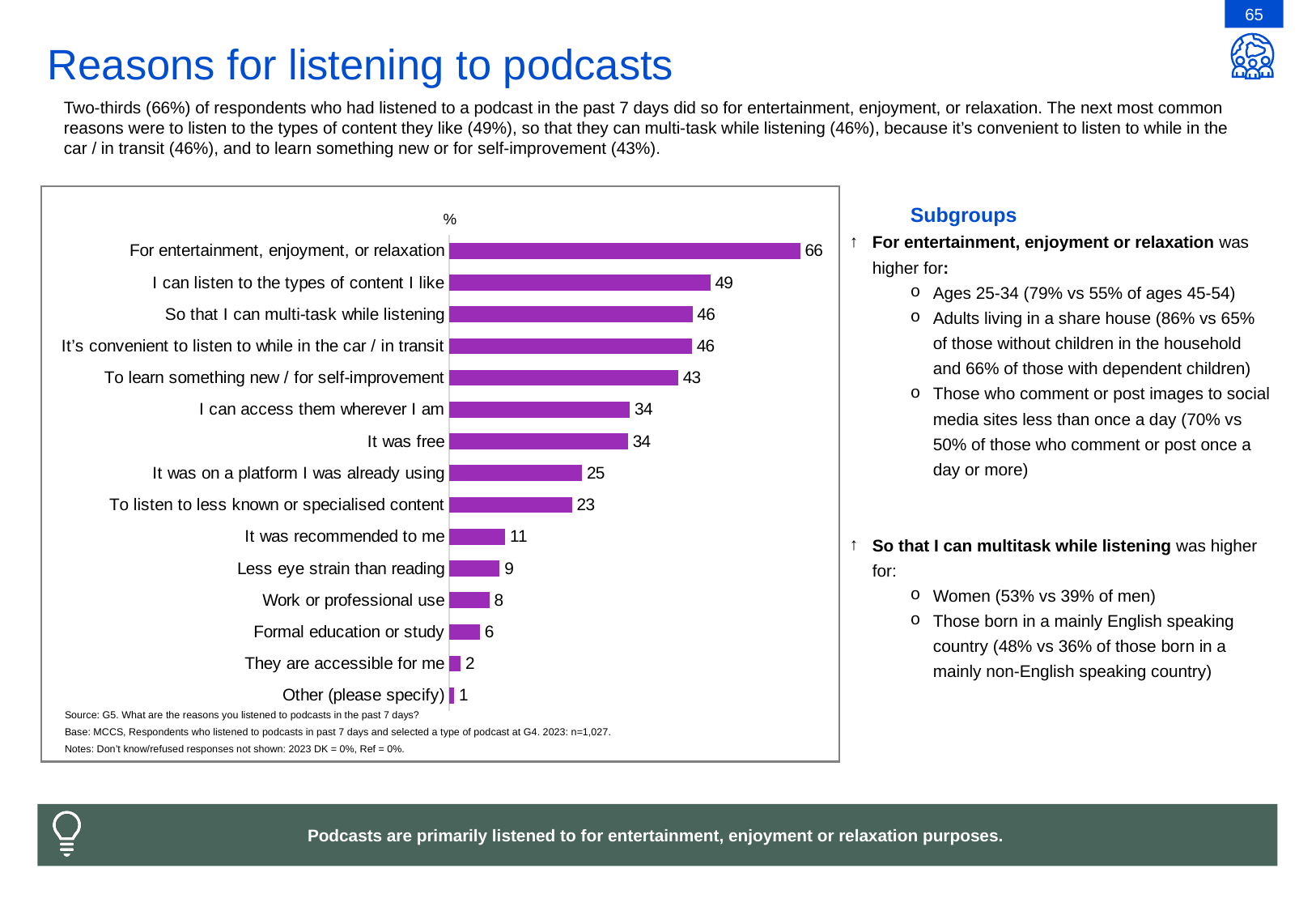
What is the difference between "It was free" and "They are accessible for me"? 32 What is the value for "For entertainment, enjoyment, or relaxation"? 66 What is the value for "It was recommended to me"? 11 Which is larger: "It was on a platform I was already using" or "To listen to less known or specialised content"? It was on a platform I was already using What kind of chart is shown on the slide? Bar chart Which category has the lowest value? Other (please specify) What is the value for "I can access them wherever I am"? 34 Which category has the highest value? For entertainment, enjoyment, or relaxation What unit is indicated at the top of the chart's axis? % What is the value for "Formal education or study"? 6 How many categories are shown in the chart? 15 What is the difference between "I can listen to the types of content I like" and "To learn something new / for self-improvement"? 6